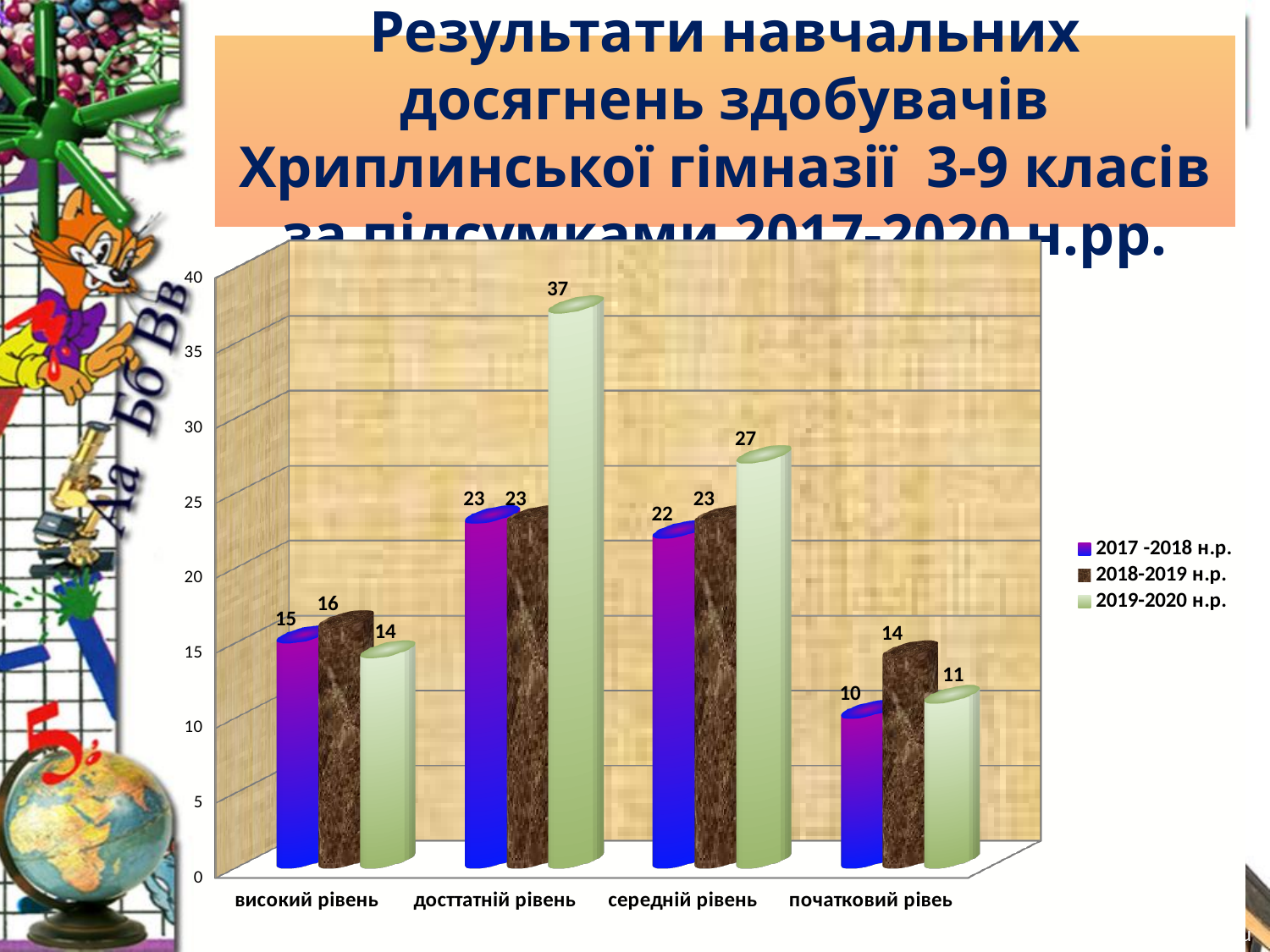
What is the value for високий рівень in the 2018-2019 н.р. series? 16 What is the difference between the 2019-2020 н.р. and 2018-2019 н.р. values for достатній рівень? 14 What kind of chart is shown on the slide? bar chart What is the difference between the 2018-2019 н.р. and 2017-2018 н.р. values for початковий рівень? 4 Which category has the highest value in the 2019-2020 н.р. series? достатній рівень Which is larger for початковий рівень: the 2018-2019 н.р. value or the 2019-2020 н.р. value? 2018-2019 н.р. What is the value for достатній рівень in the 2019-2020 н.р. series? 37 What is the value for середній рівень in the 2019-2020 н.р. series? 27 What is the value for початковий рівень in the 2017-2018 н.р. series? 10 Which category has the lowest value in the 2017-2018 н.р. series? початковий рівень How many categories are shown on the x axis? 4 How many series does the legend list? 3